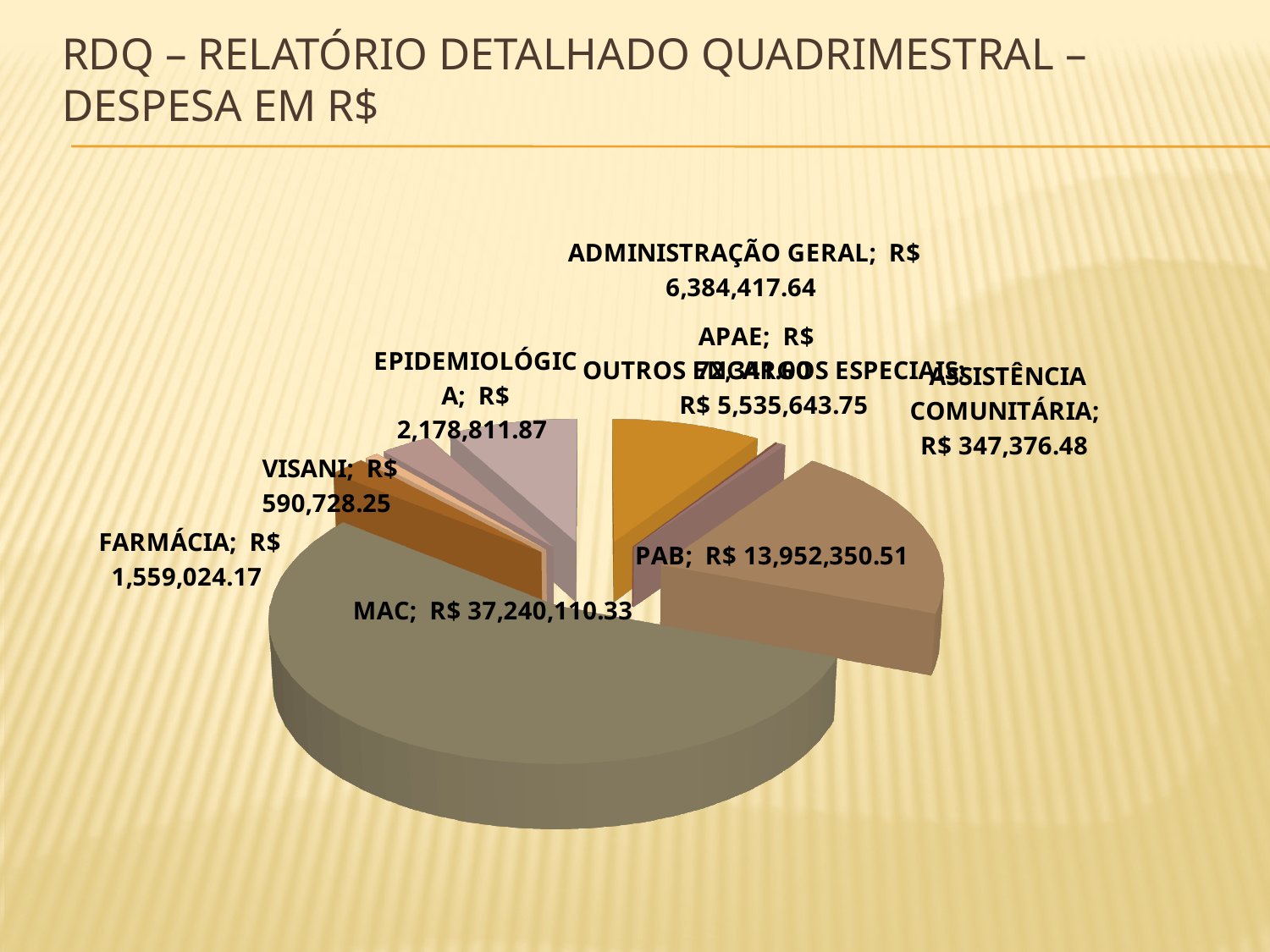
What is the value for ADMINISTRAÇÃO GERAL? R$ 6,384,417.64 Which category has the largest slice of the pie? MAC What is the difference between the values for ADMINISTRAÇÃO GERAL and EPIDEMIOLÓGICA? R$ 4,205,605.77 What is the value for MAC? R$ 37,240,110.33 What is the value for PAB? R$ 13,952,350.51 What is the value for VISANI? R$ 590,728.25 Which is larger, the value for FARMÁCIA or the value for VISANI? FARMÁCIA What is the difference between the values for PAB and OUTROS ENCARGOS ESPECIAIS? R$ 8,416,706.76 What is the value for ASSISTÊNCIA COMUNITÁRIA? R$ 347,376.48 What kind of chart is shown on the slide? pie chart What is the value for OUTROS ENCARGOS ESPECIAIS? R$ 5,535,643.75 What is the title of the slide containing the chart? RDQ – RELATÓRIO DETALHADO QUADRIMESTRAL – DESPESA EM R$